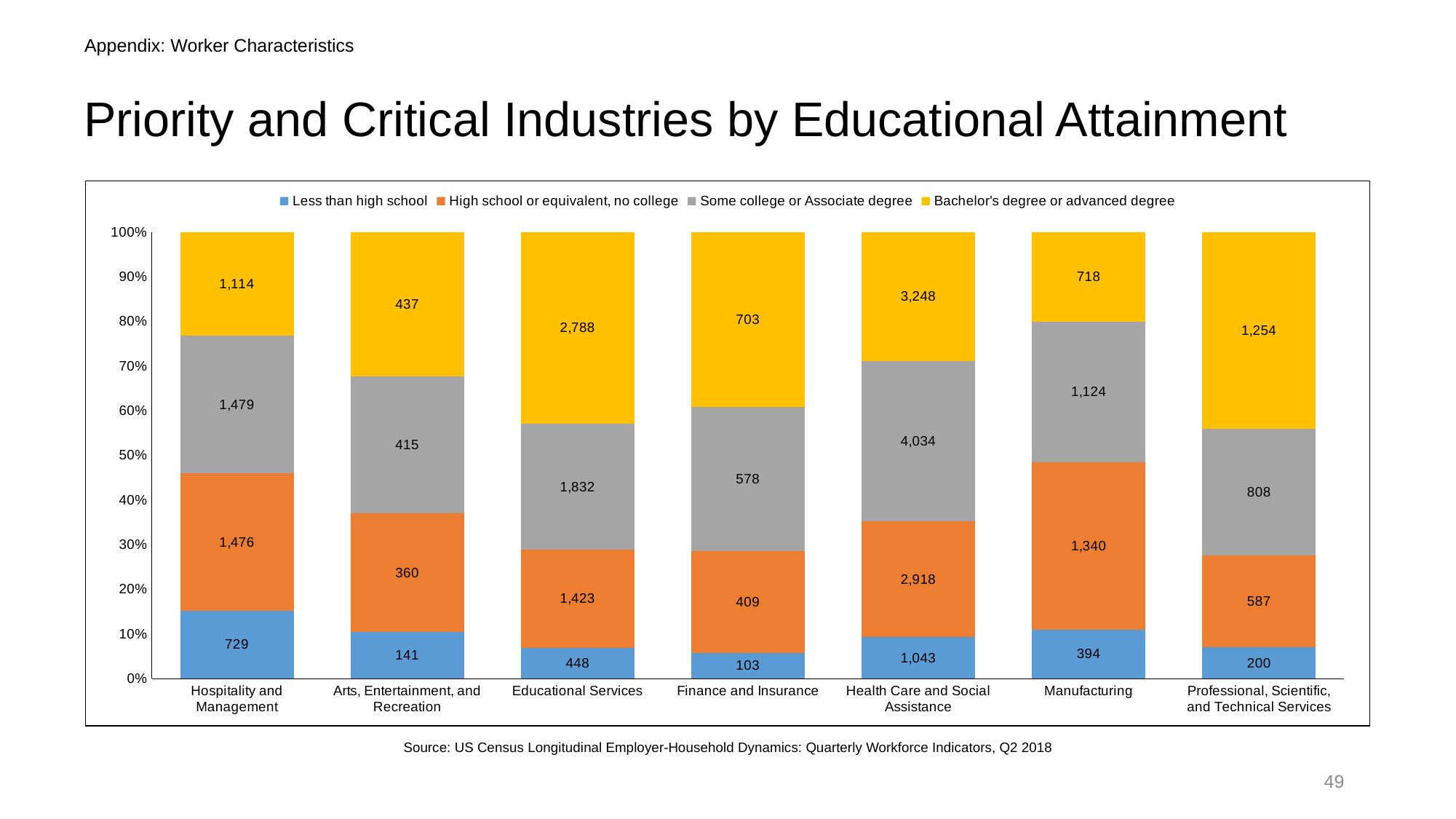
Which colour represents Bachelor's degree or advanced degree in the legend? Yellow Which industry has the highest value for Less than high school? Health Care and Social Assistance How many series does the legend list? 4 In Educational Services, what is the difference between the Bachelor's degree or advanced degree value and the Some college or Associate degree value? 956 What is the value for Less than high school in Hospitality and Management? 729 What kind of chart is shown on the slide? Stacked bar chart What is the value for Bachelor's degree or advanced degree in Health Care and Social Assistance? 3,248 What is the total of the four values in the Finance and Insurance bar? 1,793 What is the value for High school or equivalent, no college in Manufacturing? 1,340 How many industries are shown on the x axis? 7 Which industry has the lowest value for Less than high school? Finance and Insurance Which is larger in Manufacturing: the Some college or Associate degree value or the Bachelor's degree or advanced degree value? Some college or Associate degree